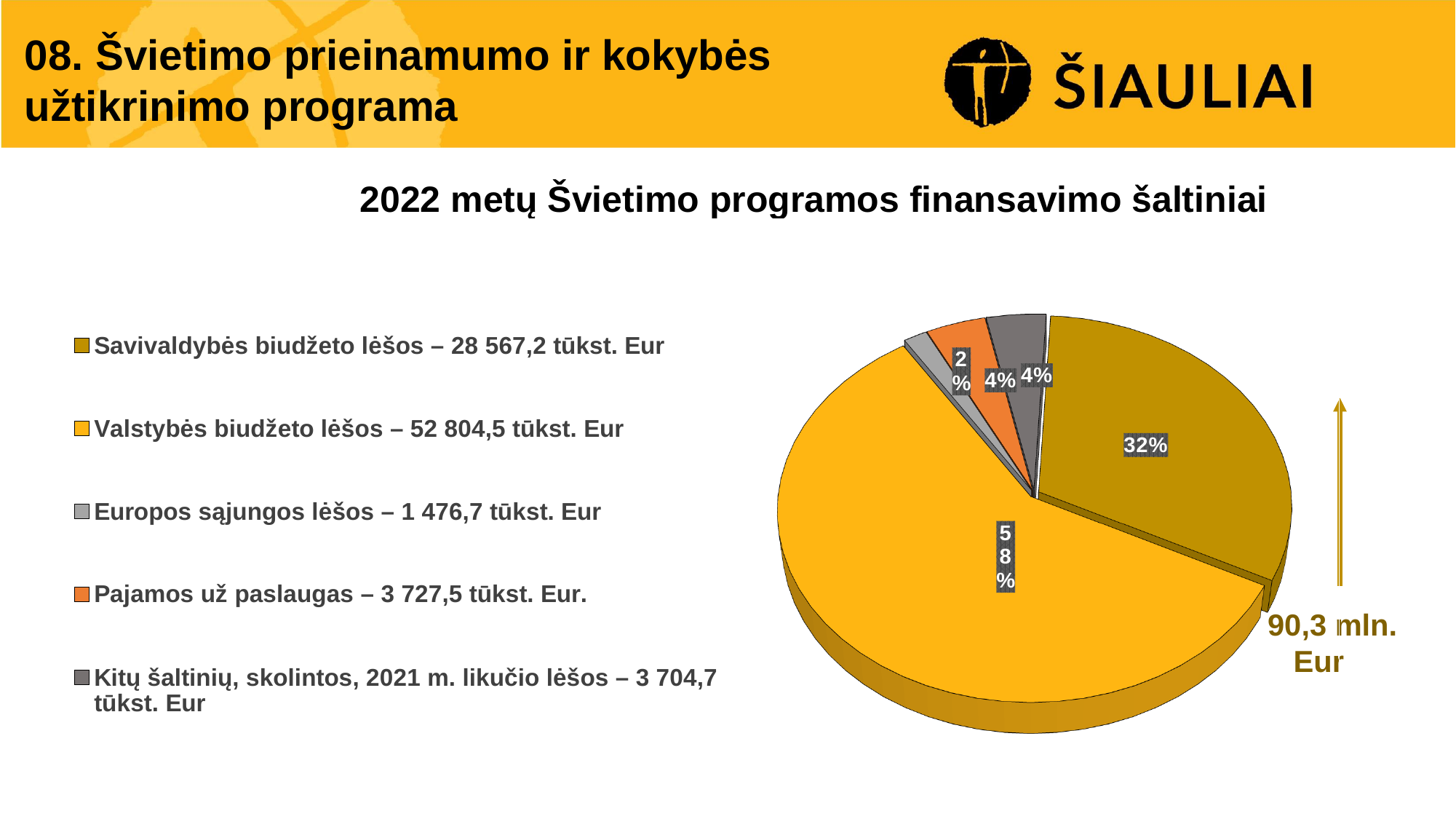
Which funding source is the smallest? Europos sąjungos lėšos What is the difference between Valstybės biudžeto lėšos and Savivaldybės biudžeto lėšos? 24 237,3 tūkst. Eur Which funding source is the largest? Valstybės biudžeto lėšos Which is larger, Pajamos už paslaugas or Kitų šaltinių, skolintos, 2021 m. likučio lėšos? Pajamos už paslaugas What is the title of the chart? 2022 metų Švietimo programos finansavimo šaltiniai What kind of chart is shown on the slide? pie chart What is the value for Savivaldybės biudžeto lėšos? 28 567,2 tūkst. Eur What share of the pie does Savivaldybės biudžeto lėšos represent? 32% What is the value for Europos sąjungos lėšos? 1 476,7 tūkst. Eur How many slices does the pie chart have? 5 What is the value for Valstybės biudžeto lėšos? 52 804,5 tūkst. Eur What share of the pie does Valstybės biudžeto lėšos represent? 58%